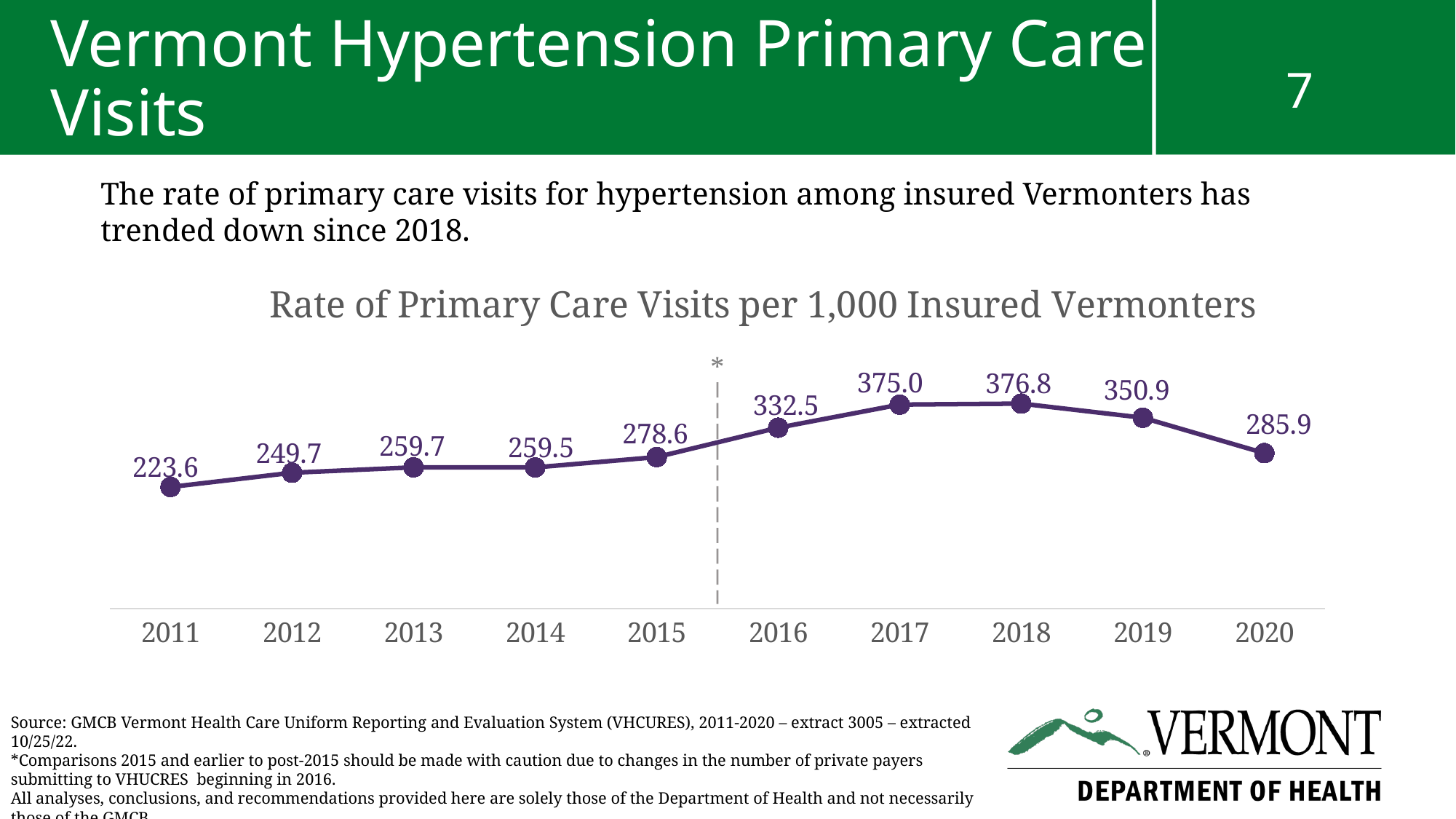
What is the difference between the rate in 2018 and the rate in 2020? 90.9 What is the rate of primary care visits per 1,000 insured Vermonters in 2016? 332.5 What is the rate of primary care visits per 1,000 insured Vermonters in 2020? 285.9 What kind of chart is shown on the slide? Line chart Does the rate of primary care visits rise or fall from 2018 to 2020? Fall Which year has the lowest rate of primary care visits per 1,000 insured Vermonters? 2011 Which year has the highest rate of primary care visits per 1,000 insured Vermonters? 2018 What is the title of the chart? Rate of Primary Care Visits per 1,000 Insured Vermonters What is the difference between the rate in 2016 and the rate in 2015? 53.9 What is the rate of primary care visits per 1,000 insured Vermonters in 2011? 223.6 Which year has a higher rate of primary care visits, 2017 or 2019? 2017 How many years are plotted on the chart? 10